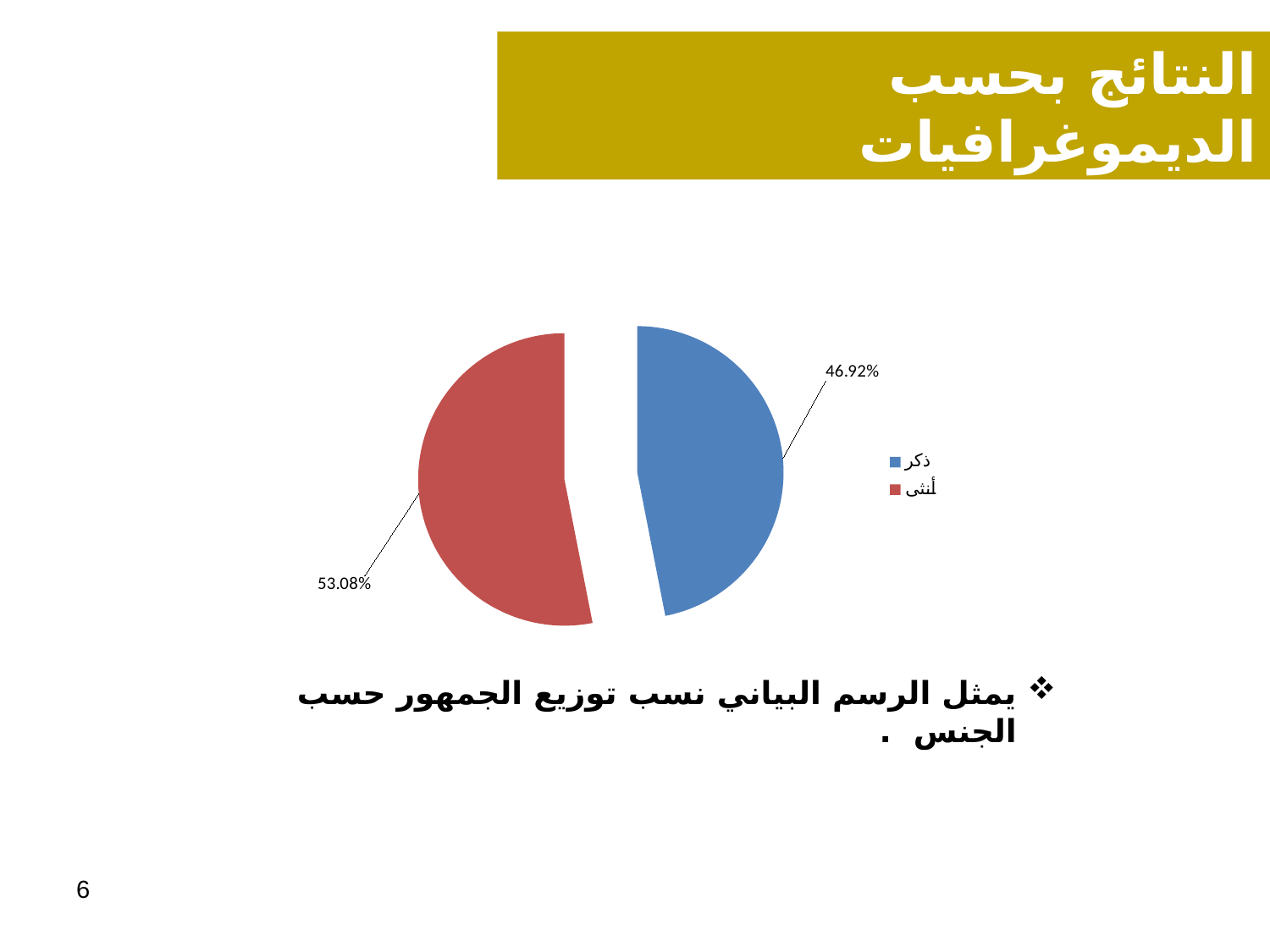
What is the difference in percentage points between the أنثى slice and the ذكر slice? 6.16 What colour is the أنثى slice in the pie chart? red Which slice is larger in the pie chart, ذكر or أنثى? أنثى Which category has the largest slice in the pie chart? أنثى What share of the pie does the ذكر slice represent? 46.92% What kind of chart is shown on the slide? pie chart Which category has the smallest slice in the pie chart? ذكر What percentage of the pie chart is labelled for ذكر? 46.92% How many slices does the pie chart have? 2 What colour is the ذكر slice in the pie chart? blue How many entries does the legend of the pie chart list? 2 What percentage of the pie chart is labelled for أنثى? 53.08%